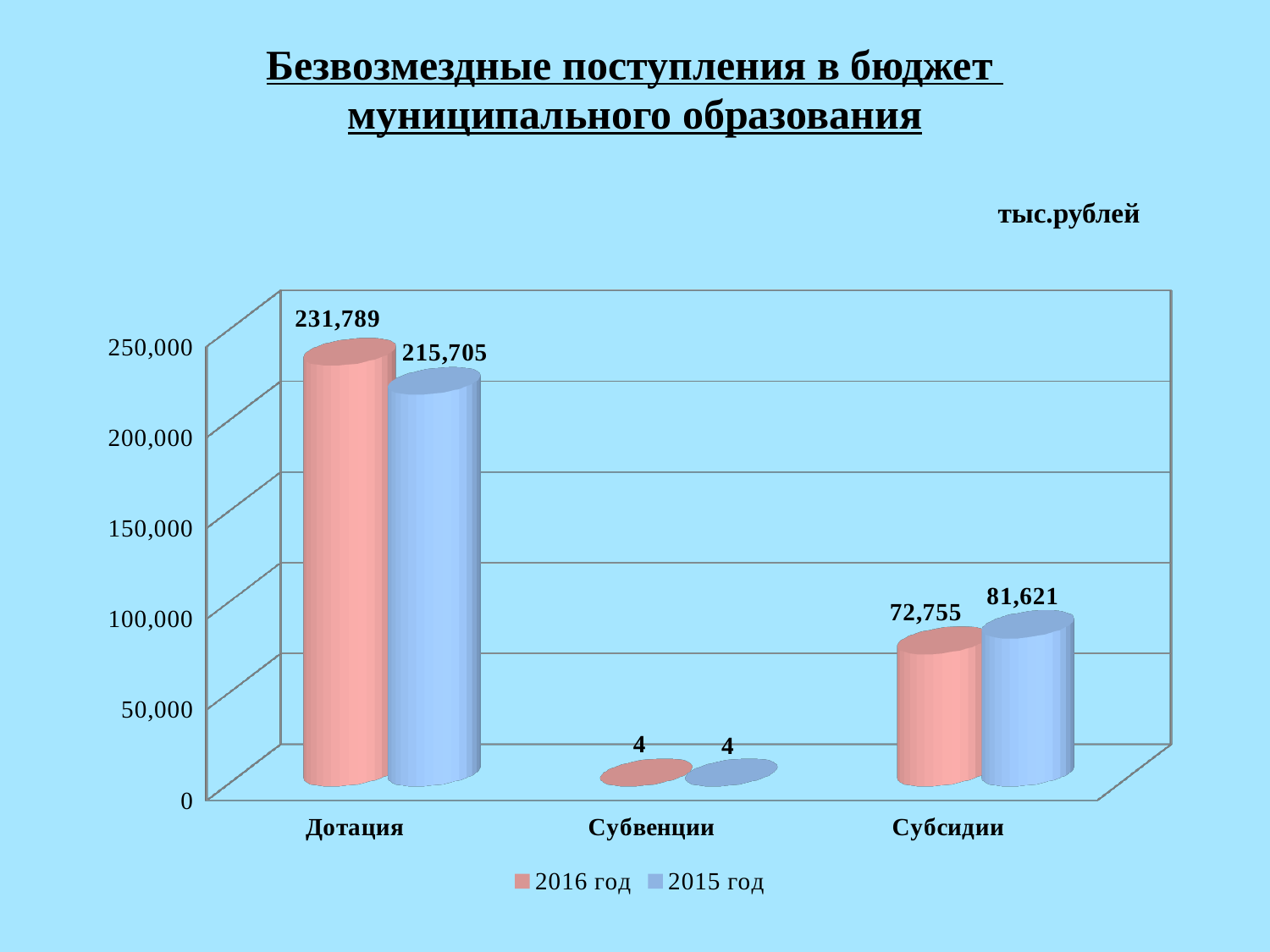
Which category has the highest value in 2016 год? Дотация How many categories are shown on the x axis? 3 What is the value for Дотация in 2016 год? 231,789 Which is larger for Субсидии: the 2016 год value or the 2015 год value? 2015 год What is the difference between the 2015 год and 2016 год values for Субсидии? 8,866 What is the difference between the 2016 год and 2015 год values for Дотация? 16,084 What is the value for Субвенции in 2016 год? 4 What is the value for Субсидии in 2015 год? 81,621 What is the value for Дотация in 2015 год? 215,705 How many series does the legend list? 2 What kind of chart is shown on the slide? bar chart Which category has the lowest value in 2015 год? Субвенции